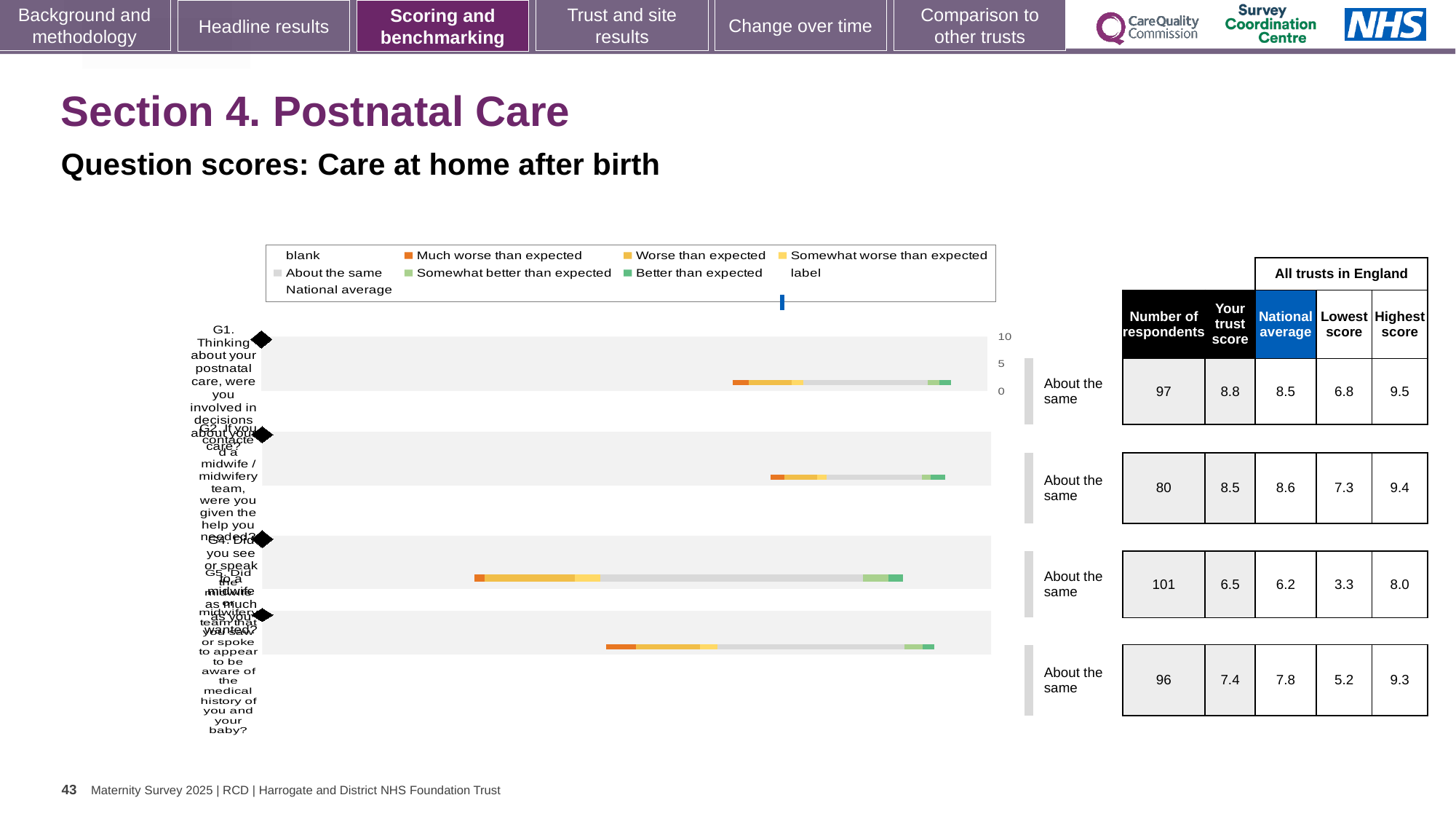
What is the highest score across all trusts in England for the fourth question row? 9.3 What benchmark category is shown for each of the four question rows? About the same What kind of chart is shown on the slide? bar chart What is the difference between the trust score and the national average for the fourth question row? 0.4 Which question row has the highest number of respondents? the third row (101) Which question row has the lowest trust score? the third row (6.5) What is the lowest score across all trusts in England for the third question row? 3.3 What is the national average for the second question row (G2)? 8.6 For the first question row (G1), is the trust score or the national average larger? trust score (8.8) How many question rows (bars) are plotted in the chart? 4 What is the trust score for the first question row (G1)? 8.8 What is the number of respondents for the first question row (G1)? 97